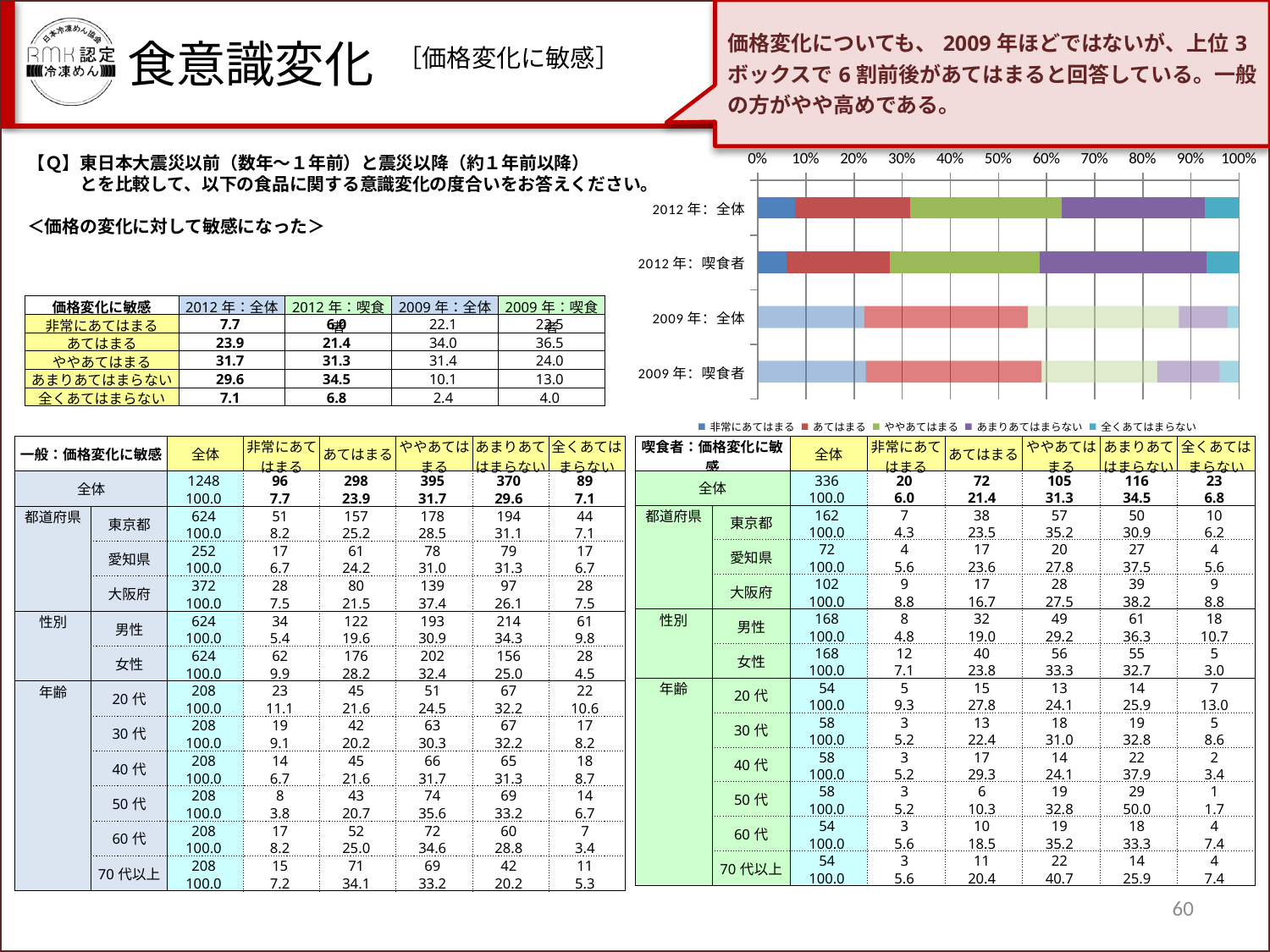
Which bar has the larger 非常にあてはまる segment, 2012年：全体 or 2009年：全体? 2009年：全体 How many series does the chart legend list? 5 Is the 非常にあてはまる segment for 2009年：全体 greater or less than 10%? greater What kind of chart is shown on the slide? Stacked bar chart Which bar has the larger あまりあてはまらない segment, 2012年：喫食者 or 2009年：喫食者? 2012年：喫食者 Is the 全くあてはまらない segment for 2009年：全体 greater or less than 10%? less How many bars (categories) does the chart show? 4 Is the あまりあてはまらない segment for 2012年：喫食者 greater or less than 20%? greater What is the maximum value shown on the chart's horizontal axis? 100% Which of the four bars has the smallest 非常にあてはまる segment? 2012年：喫食者 What is the first entry in the chart legend? 非常にあてはまる